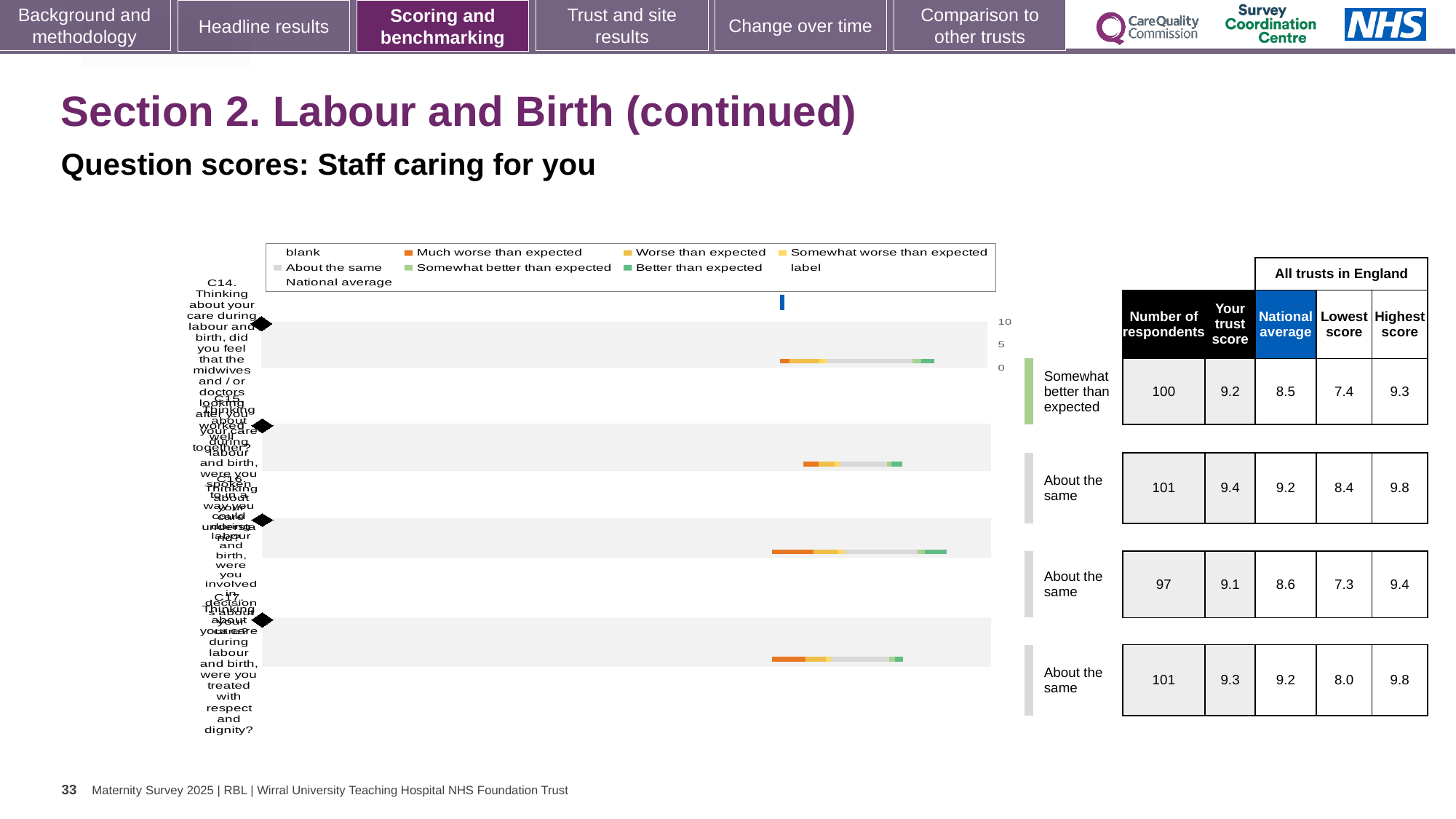
Which legend entry is shown in orange? Much worse than expected What is the difference between 'Your trust score' and the national average for the first (top) row? 0.7 In the table next to the chart, what is the highest score for the fourth (bottom) row? 9.8 What benchmark label is shown for the first (top) row of the chart? Somewhat better than expected What type of chart is shown on the slide? bar chart How many question rows (bars) are plotted in the chart? 4 In the table next to the chart, what is the national average for the third row? 8.6 Which row of the table has the highest 'Your trust score'? the second row (9.4) For the third row, which is larger: 'Your trust score' or the national average? Your trust score In the table next to the chart, what is the number of respondents for the first (top) row? 100 In the table next to the chart, what is the 'Your trust score' value for the first (top) row? 9.2 Which row of the table has the lowest value in the 'Lowest score' column? the third row (7.3)